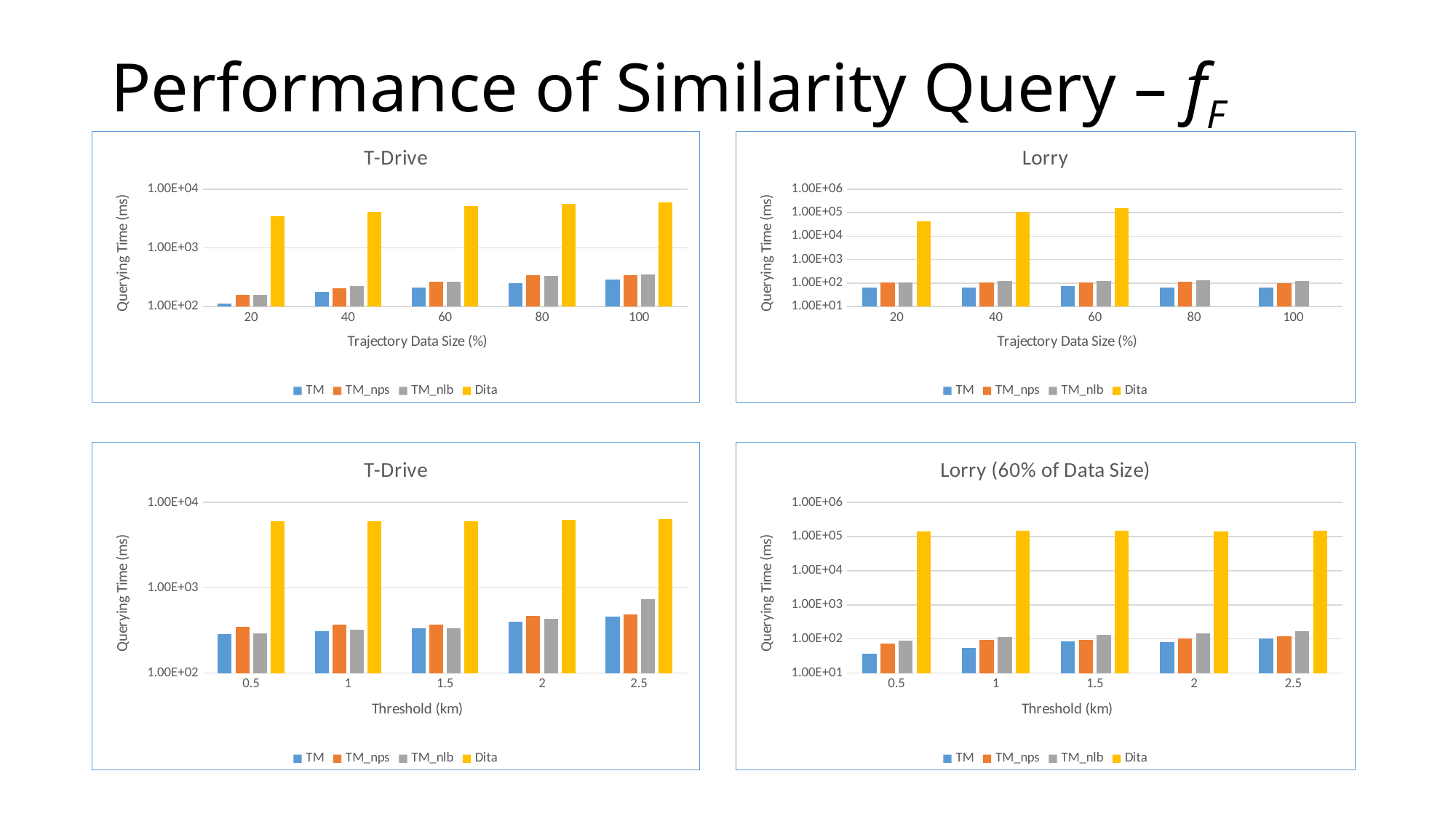
In the bottom-left T-Drive chart, is the querying time for Dita at a threshold of 0.5 greater or less than 1.00E+04? less In the bottom-right Lorry (60% of Data Size) chart, which series has the lowest querying time at a threshold of 0.5? TM In the top-left T-Drive chart, does the querying time for TM rise or fall as the trajectory data size increases? rises In the top-right Lorry chart, at how many data sizes is a Dita bar plotted? 3 What is the label of the y axis in the bottom-right chart? Querying Time (ms) In the bottom-left T-Drive chart, at a threshold of 2.5, which is larger: TM_nps or TM_nlb? TM_nlb In the bottom-right Lorry (60% of Data Size) chart, is the querying time for TM at a threshold of 0.5 greater or less than 1.00E+02? less In the top-right Lorry chart, which series has the highest querying time at a data size of 60? Dita In the top-left T-Drive chart, is the querying time for Dita at a data size of 20 greater or less than 1.00E+03? greater In the top-left T-Drive chart, how many series does the legend list? 4 In the top-left T-Drive chart, what kind of chart is shown? bar chart In the bottom-left T-Drive chart, how many threshold categories are shown on the x axis? 5